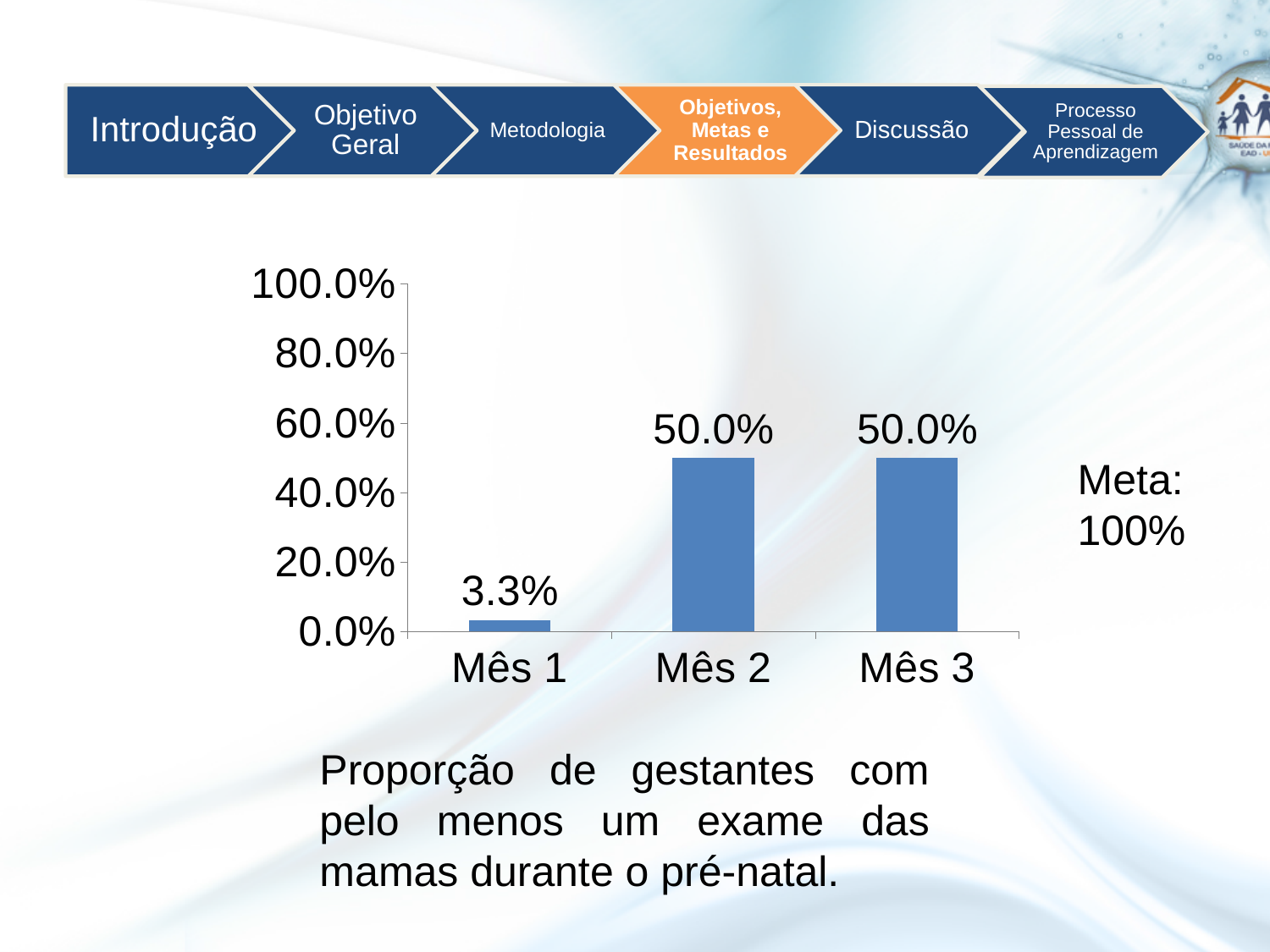
What is the value for Mês 1? 3.3% Is the value for Mês 1 greater or less than 20.0%? less What is the value for Mês 2? 50.0% Is the value for Mês 2 greater or less than 40.0%? greater Do the values rise or fall from Mês 1 to Mês 2? rise What is the difference between the values for Mês 2 and Mês 1? 46.7% Which is larger, the value for Mês 1 or the value for Mês 3? Mês 3 What is the value for Mês 3? 50.0% What kind of chart is shown on the slide? bar chart What target (Meta) is stated next to the chart? 100% How many months are shown on the x axis? 3 Which month has the lowest value? Mês 1